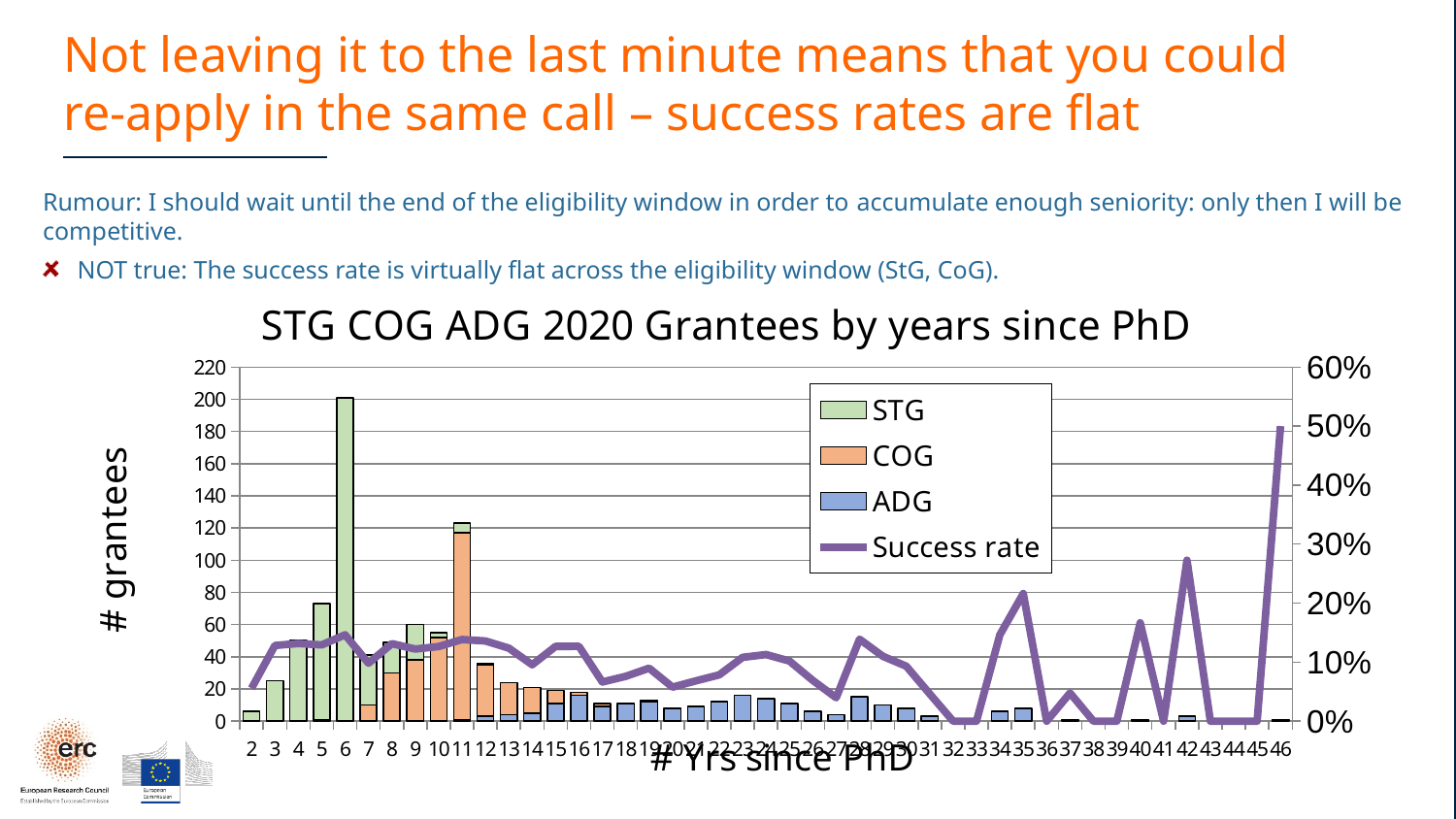
Which series is plotted as a line rather than bars? Success rate Is the number of grantees at 6 years since PhD greater or less than 180? greater Which has more grantees: 6 years since PhD or 11 years since PhD? 6 years since PhD How many series does the chart legend list? 4 Is the number of grantees at 11 years since PhD greater or less than 100? greater Is the number of grantees at 4 years since PhD greater or less than 60? less What is the title of the chart? STG COG ADG 2020 Grantees by years since PhD At which number of years since PhD is the tallest bar in the chart? 6 Which series has the tallest bar in the chart? STG What kind of chart is shown on the slide? Combined bar and line chart At which number of years since PhD is the tallest COG bar? 11